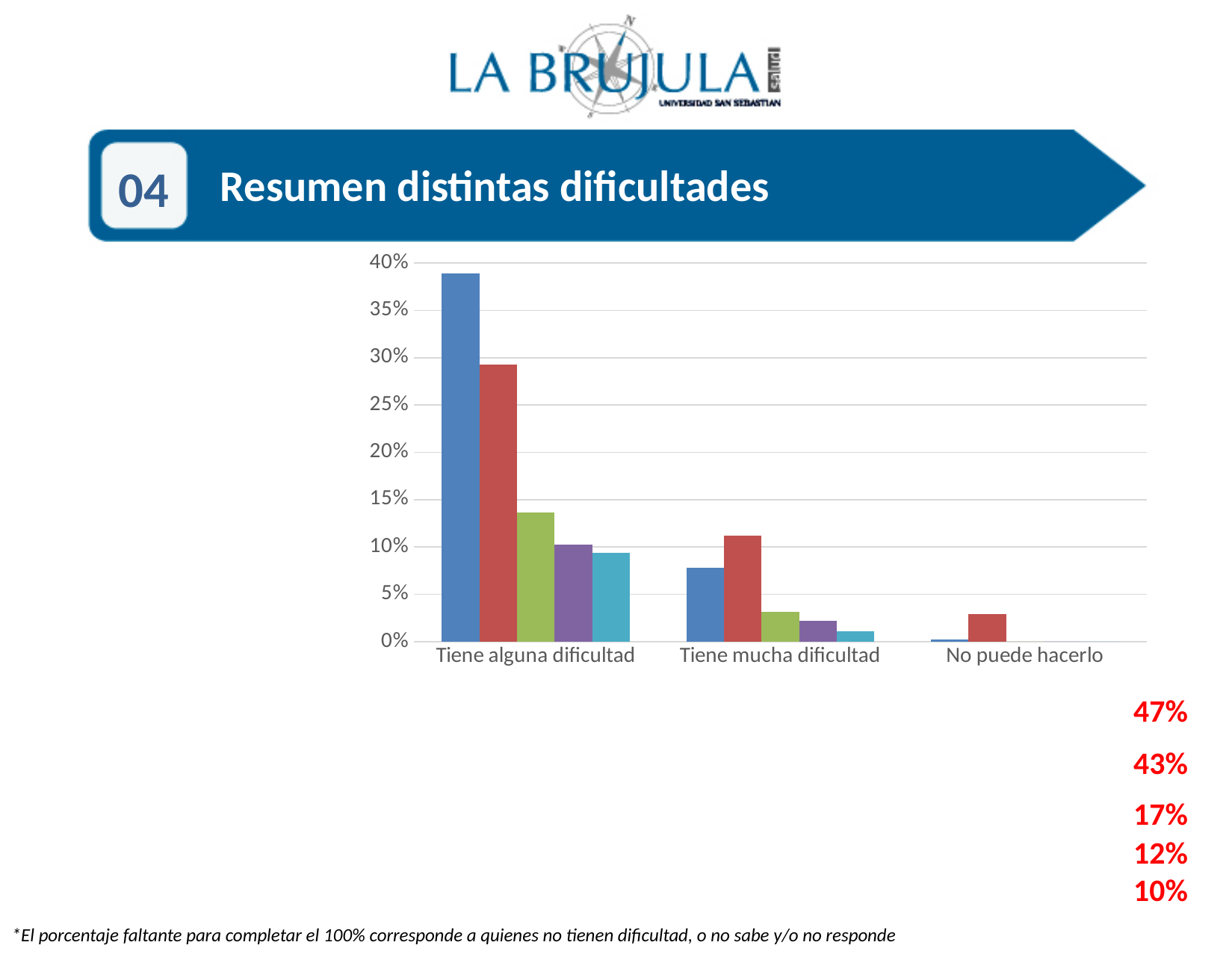
How many categories are shown on the x axis of the chart? 3 What is the title shown in the banner above the chart? Resumen distintas dificultades Do the values of the blue bars rise or fall from left to right across the categories? fall What kind of chart is shown on the slide? bar chart Is the value of the blue bar for "Tiene mucha dificultad" greater or less than 10%? less For "Tiene alguna dificultad", which bar is taller, the blue one or the red one? the blue one Is the value of the blue bar for "Tiene alguna dificultad" greater or less than 35%? greater Which category contains the tallest bar in the chart? Tiene alguna dificultad Is the value of the red bar for "No puede hacerlo" greater or less than 5%? less For "Tiene mucha dificultad", which bar is taller, the red one or the green one? the red one How many bars are plotted for the category "Tiene alguna dificultad"? 5